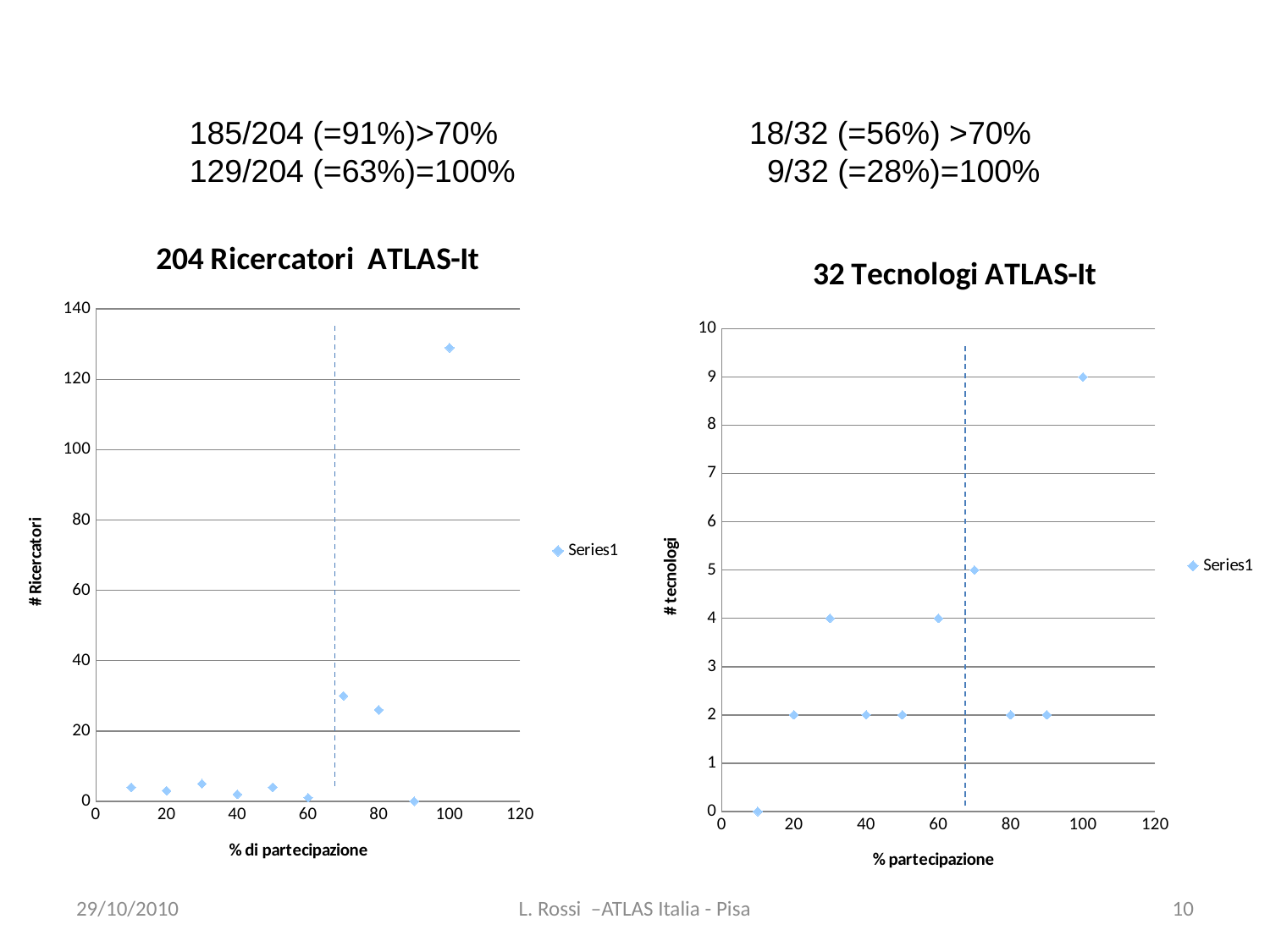
In the '32 Tecnologi ATLAS-It' chart, how many data points are plotted? 10 How many series does the legend of the '204 Ricercatori ATLAS-It' chart list? 1 In the '204 Ricercatori ATLAS-It' chart, is the # Ricercatori value at 100% di partecipazione greater or less than 120? greater In the '32 Tecnologi ATLAS-It' chart, at which % partecipazione is the # tecnologi value lowest? 10 In the '32 Tecnologi ATLAS-It' chart, what is the difference between the # tecnologi values at 100% and 70% partecipazione? 4 In the '32 Tecnologi ATLAS-It' chart, at which % partecipazione is the # tecnologi value highest? 100 In the '32 Tecnologi ATLAS-It' chart, which has a larger # tecnologi value: 30% or 20% partecipazione? 30 What kind of chart is the '32 Tecnologi ATLAS-It' chart? scatter chart In the '32 Tecnologi ATLAS-It' chart, what is the # tecnologi value at 10% partecipazione? 0 In the '32 Tecnologi ATLAS-It' chart, what is the # tecnologi value at 70% partecipazione? 5 In the '204 Ricercatori ATLAS-It' chart, at which % di partecipazione is the # Ricercatori value highest? 100 In the '32 Tecnologi ATLAS-It' chart, what is the # tecnologi value at 100% partecipazione? 9